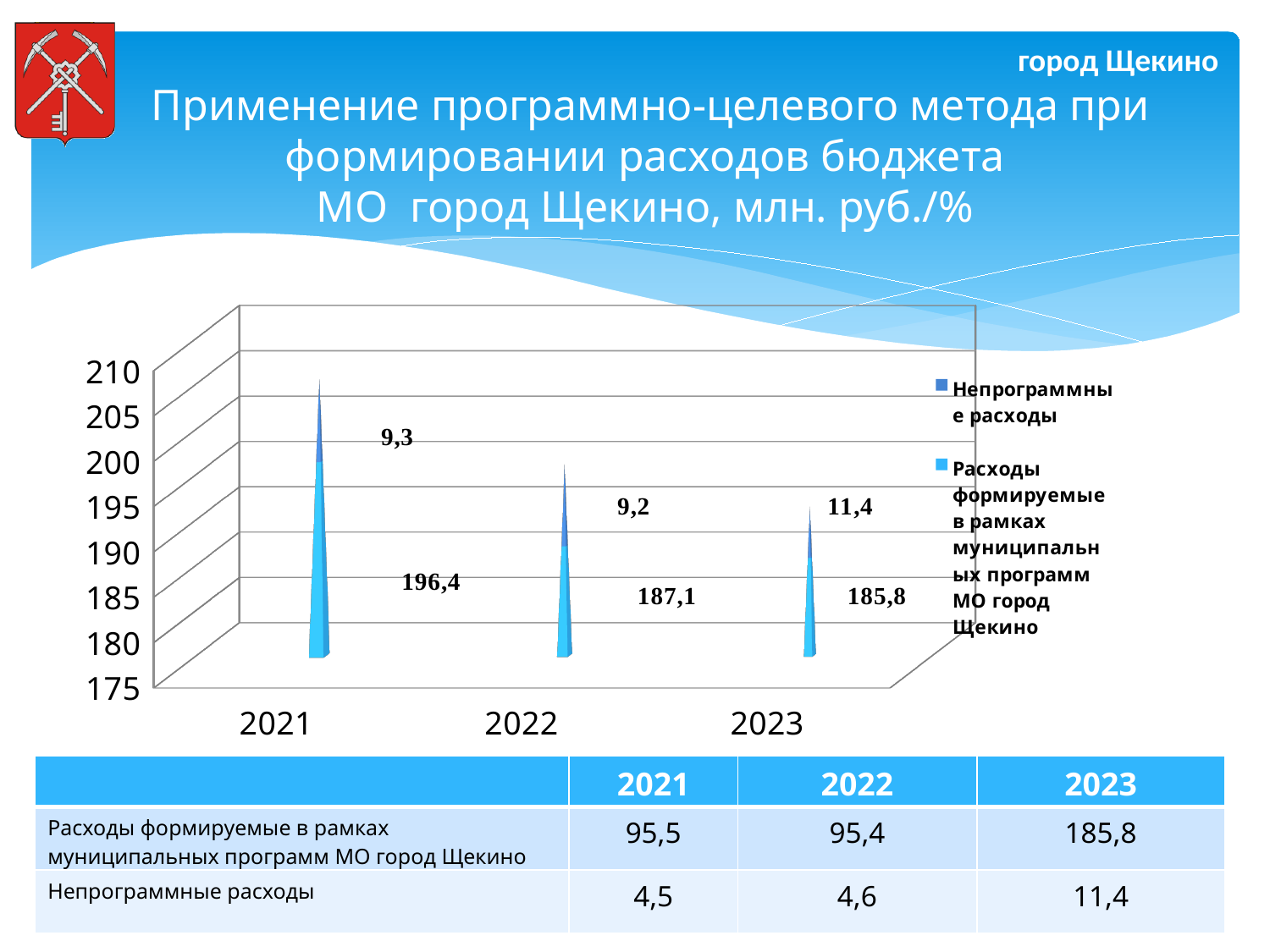
In which year is «Непрограммные расходы» the highest? 2023 Which is larger: «Непрограммные расходы» in 2021 or in 2022? 2021 What is the difference between «Расходы формируемые в рамках муниципальных программ МО город Щекино» in 2021 and in 2022? 9,3 What is the value of «Непрограммные расходы» for 2021? 9,3 What is the total of the stacked bar for 2021? 205,7 How many years are shown on the x axis of the chart? 3 In which year is «Расходы формируемые в рамках муниципальных программ МО город Щекино» the highest? 2021 What is the difference between «Непрограммные расходы» in 2023 and in 2021? 2,1 What is the value of «Расходы формируемые в рамках муниципальных программ МО город Щекино» for 2022? 187,1 How many series does the chart legend list? 2 In which year is «Расходы формируемые в рамках муниципальных программ МО город Щекино» the lowest? 2023 What is the value of «Непрограммные расходы» for 2023? 11,4